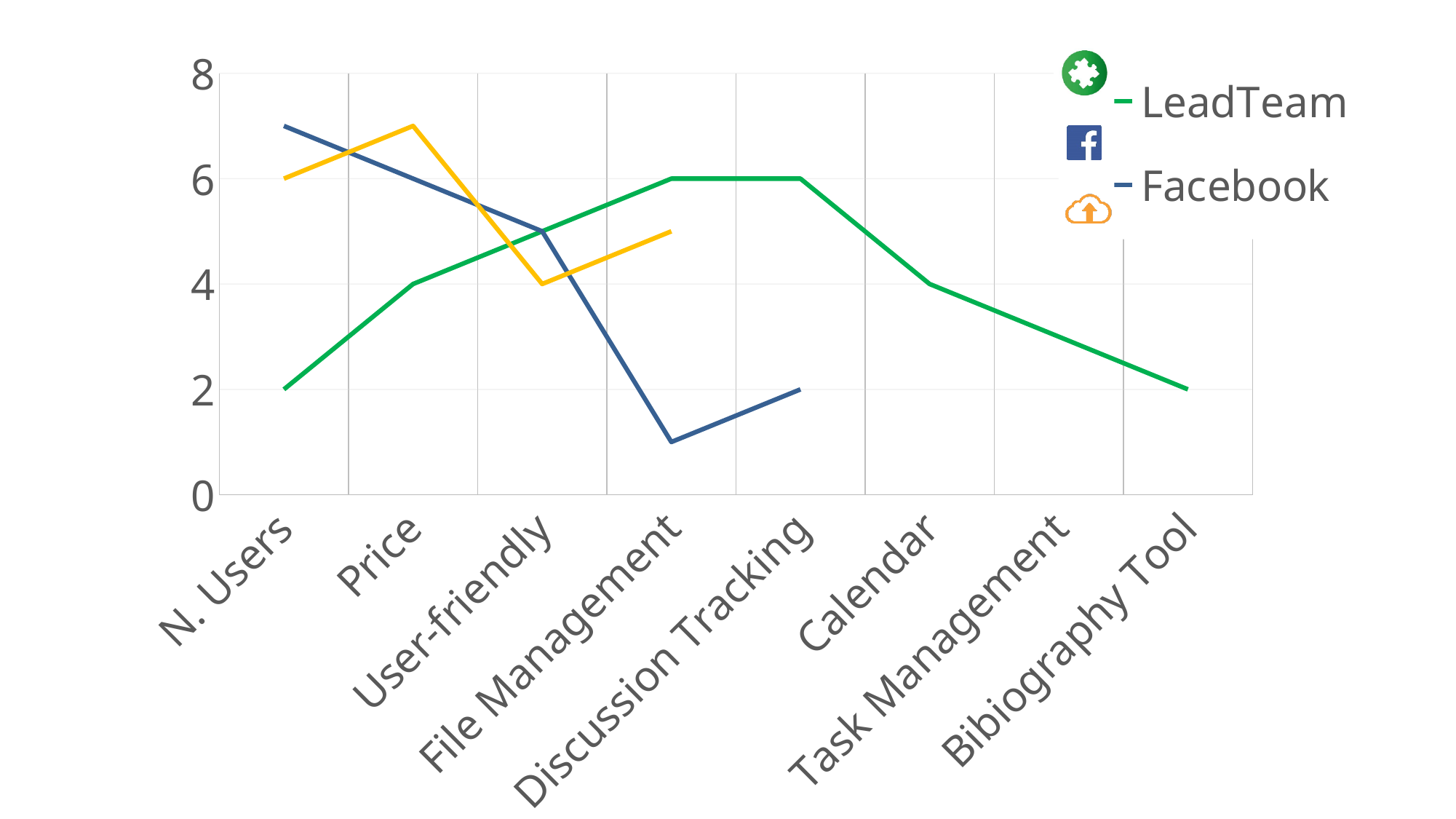
How many categories are shown along the x axis? 8 Is the Facebook value for File Management greater or less than 2? less What is the LeadTeam value for Calendar? 4 What kind of chart is shown on the slide? line chart What colour is the LeadTeam line? green What is the LeadTeam value for N. Users? 2 Which series has the larger value for Discussion Tracking, LeadTeam or Facebook? LeadTeam What is the difference between the LeadTeam and Facebook values for Discussion Tracking? 4 Which category has the lowest Facebook value? File Management What is the Facebook value for Price? 6 What is the Facebook value for Discussion Tracking? 2 Which category has the highest Facebook value? N. Users